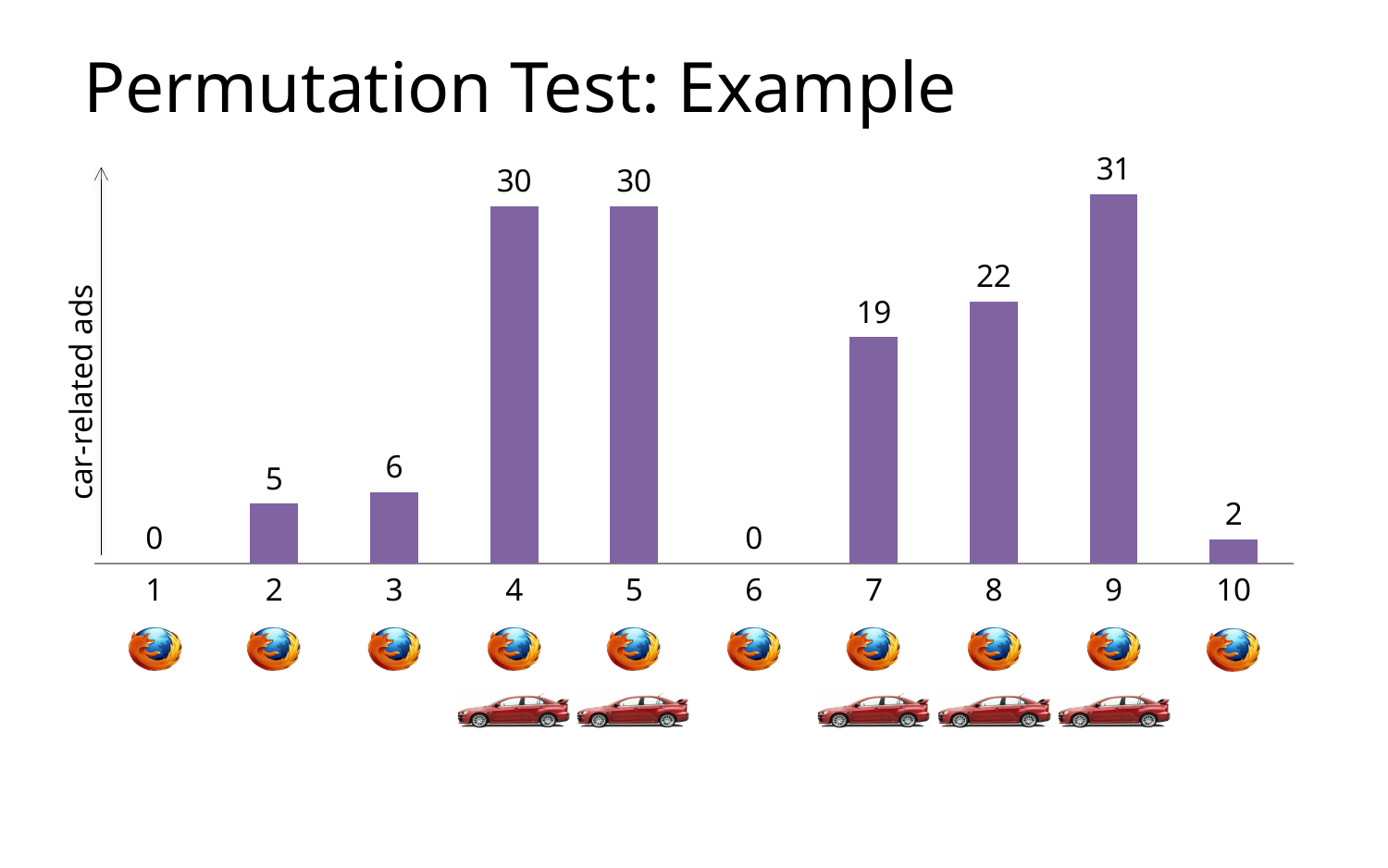
What is the title of the slide? Permutation Test: Example Which category has the highest number of car-related ads? 9 Which categories have the lowest number of car-related ads? 1 and 6 What is the difference in car-related ads between category 9 and category 7? 12 What kind of chart is shown on the slide? bar chart What is the value of car-related ads for category 4? 30 What is the label of the y axis? car-related ads How many categories are shown on the x axis? 10 What is the difference in car-related ads between category 5 and category 2? 25 What is the value of car-related ads for category 8? 22 Which has more car-related ads, category 3 or category 8? 8 What is the value of car-related ads for category 10? 2